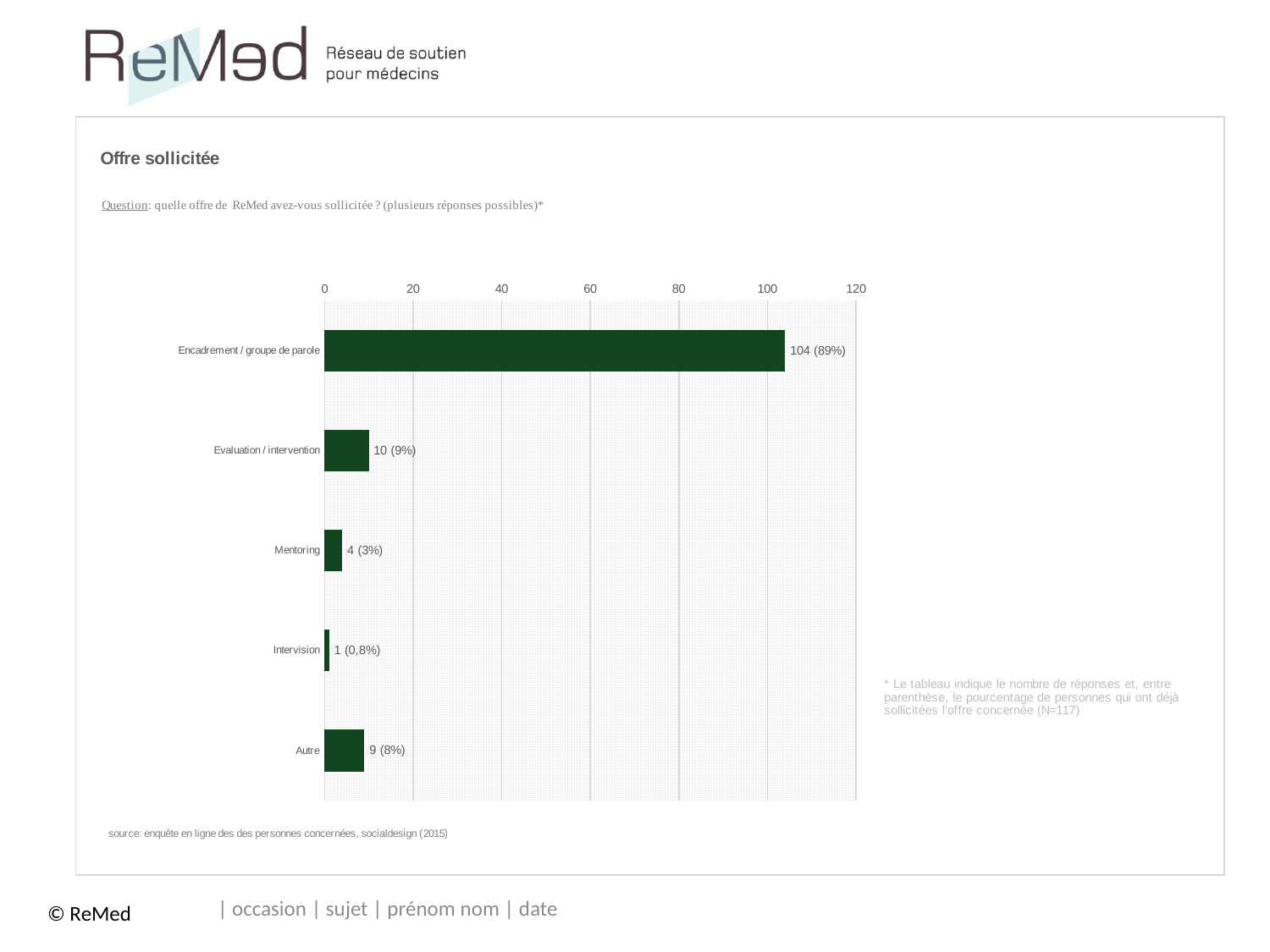
Which category has the highest number of responses? Encadrement / groupe de parole Which has more responses, Autre or Mentoring? Autre Which category has the lowest number of responses? Intervision What is the value shown for Mentoring? 4 (3%) What is the difference in number of responses between Encadrement / groupe de parole and Evaluation / intervention? 94 How many categories are shown in the chart? 5 What is the value shown for Autre? 9 (8%) What is the value shown for Encadrement / groupe de parole? 104 (89%) Is the value for Encadrement / groupe de parole greater or less than 100? greater What is the value shown for Evaluation / intervention? 10 (9%) What kind of chart is shown on the slide? Bar chart What is the value shown for Intervision? 1 (0,8%)